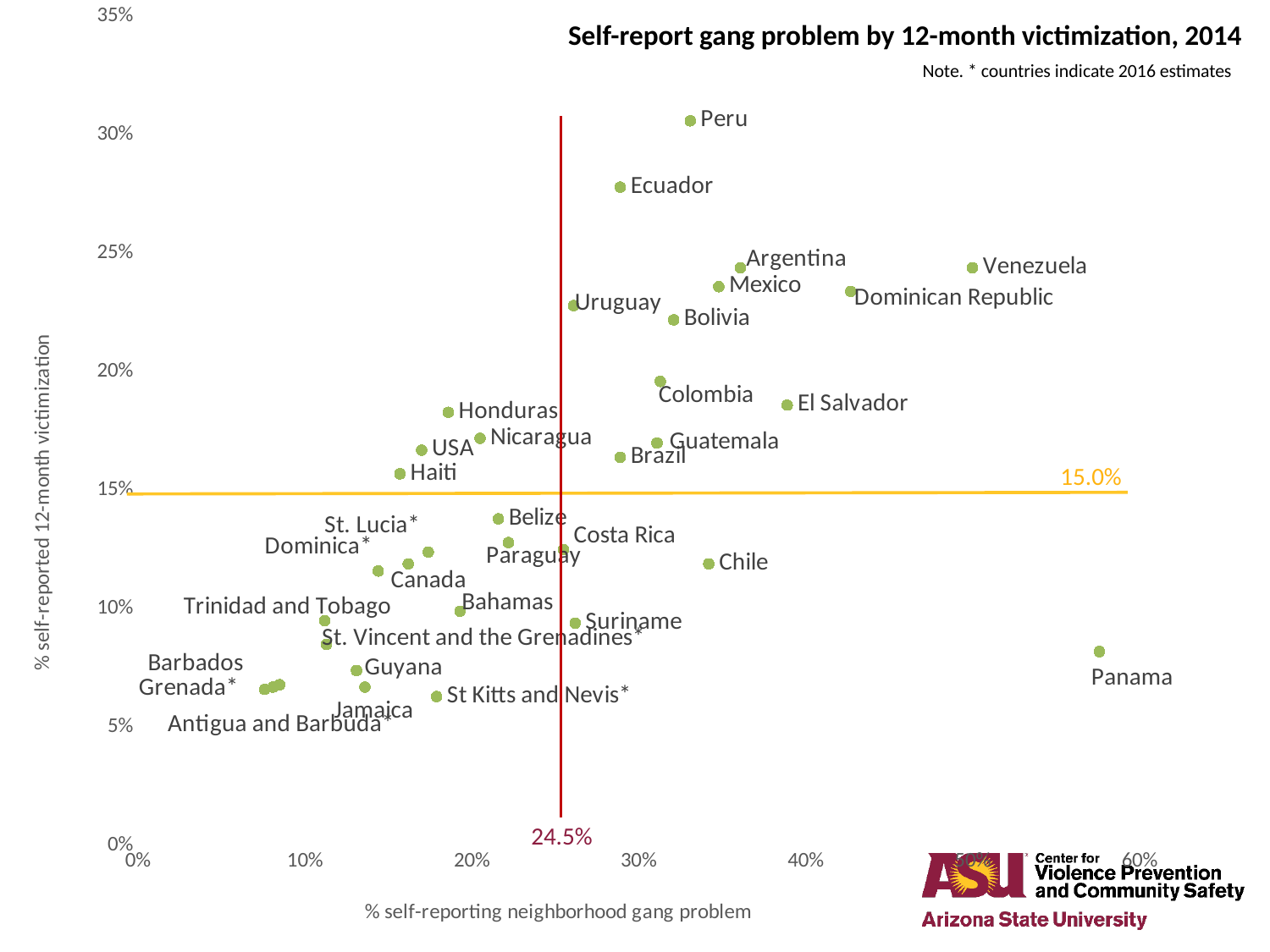
Which country has the highest percentage self-reporting a neighborhood gang problem? Panama Is the self-reported 12-month victimization for Chile greater or less than 15%? less Is the percentage self-reporting a neighborhood gang problem for Panama greater or less than 50%? greater According to the note, what do the asterisks on country names indicate? 2016 estimates What value is marked by the vertical reference line on the chart? 24.5% Is the self-reported 12-month victimization for Peru greater or less than 25%? greater What value is marked by the horizontal reference line on the chart? 15.0% Which has a higher self-reported 12-month victimization, Peru or Ecuador? Peru What is the title of the chart? Self-report gang problem by 12-month victimization, 2014 Which has a higher percentage self-reporting a neighborhood gang problem, Venezuela or Uruguay? Venezuela Which country has the highest self-reported 12-month victimization? Peru What kind of chart is shown on the slide? Scatter plot